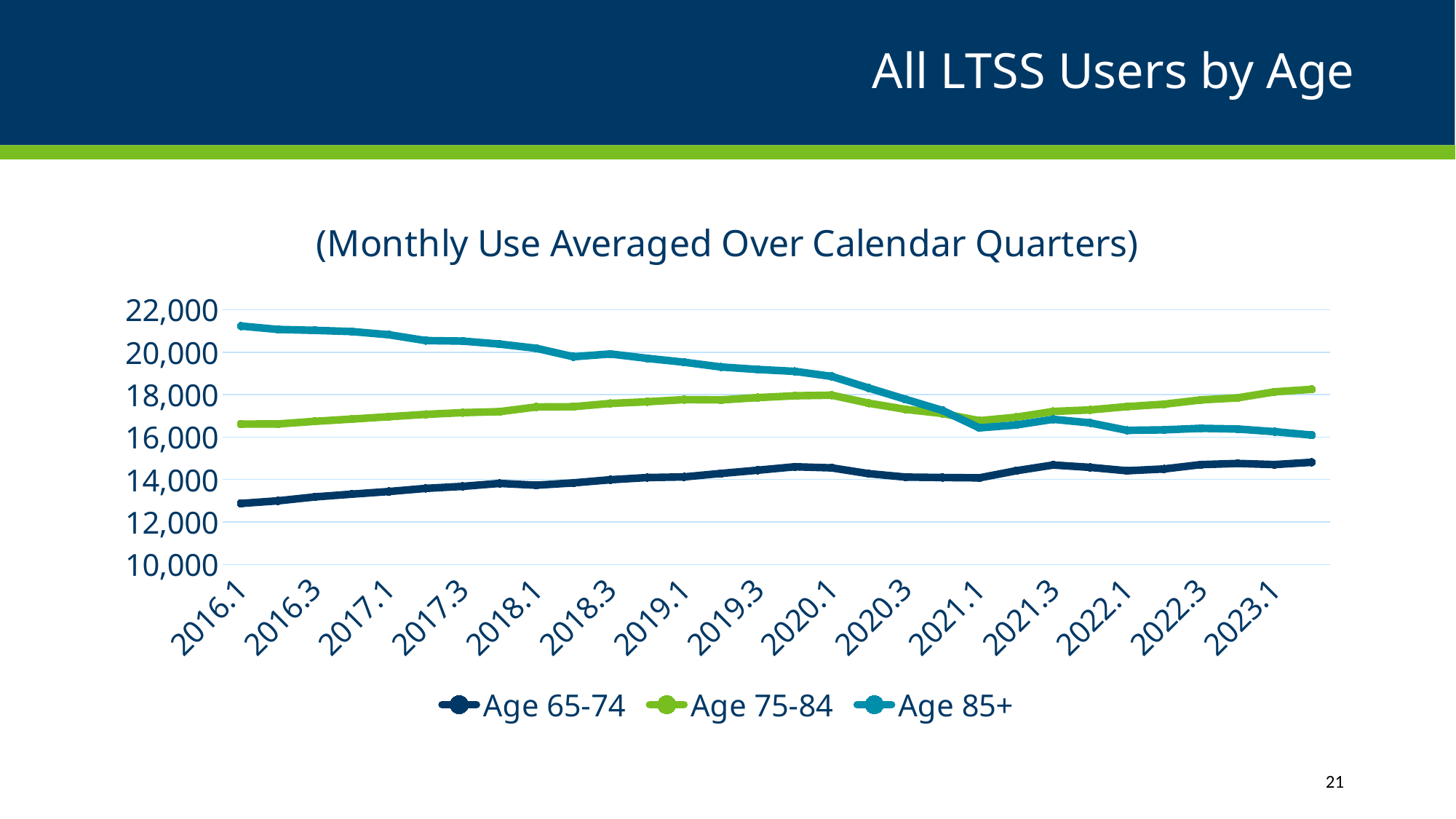
Is the value for Age 65-74 at 2016.1 greater or less than 14,000? less Is the value for Age 85+ at 2023.1 greater or less than 18,000? less What is the subtitle shown above the chart? (Monthly Use Averaged Over Calendar Quarters) Which age group has the highest value at 2016.1? Age 85+ Which age group has the lowest value at 2016.1? Age 65-74 Does the Age 65-74 line generally rise or fall from 2016.1 to 2023.1? Rise How many series does the legend list? 3 Which age group has the highest value at 2023.1? Age 75-84 What kind of chart is shown on the slide? Line chart Is the value for Age 85+ at 2016.1 greater or less than 20,000? greater Does the Age 85+ line generally rise or fall from 2016.1 to 2023.1? Fall At 2019.1, which is larger: the value for Age 75-84 or the value for Age 65-74? Age 75-84